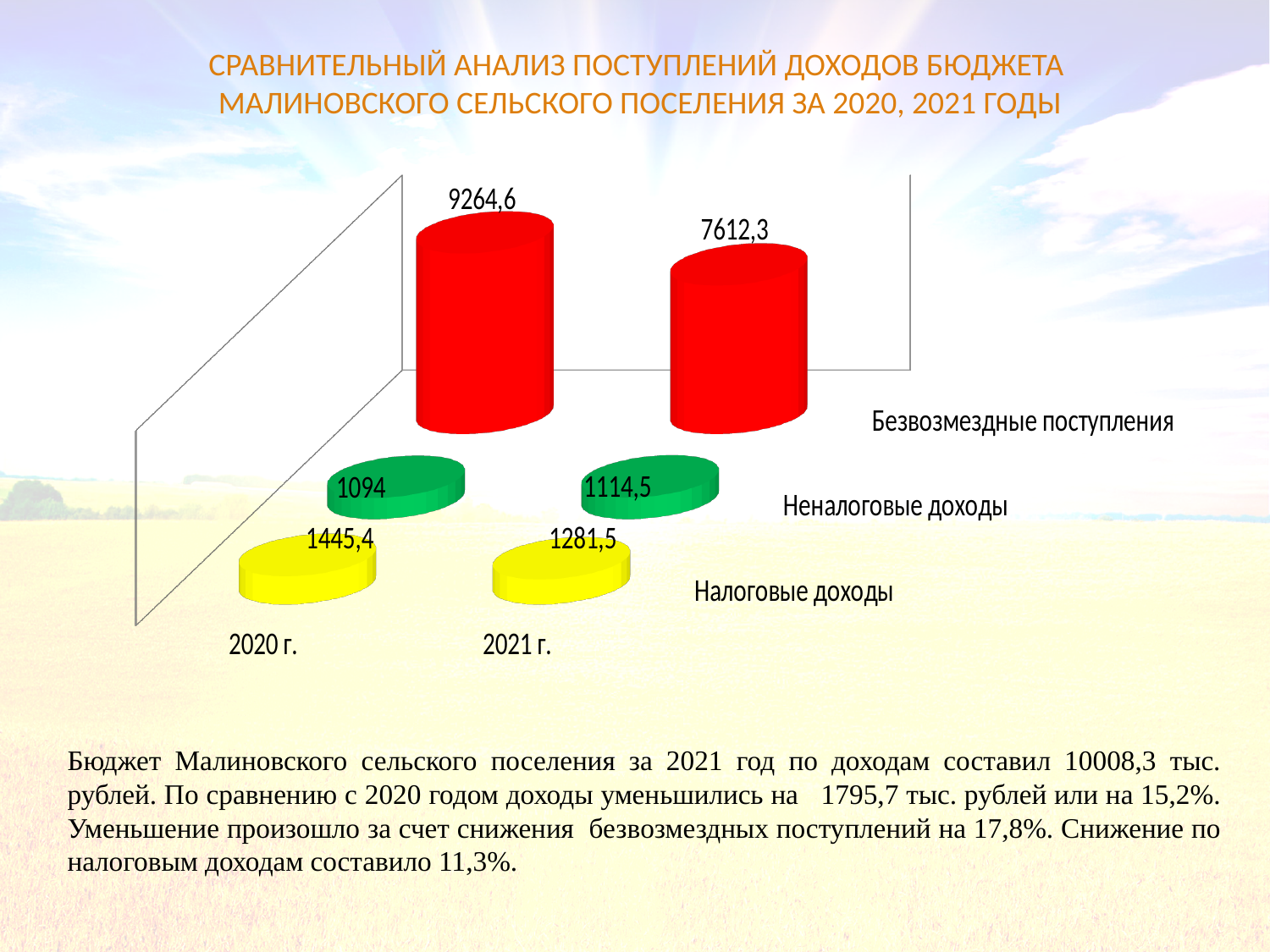
Which series has the lowest value for 2021 г.? Неналоговые доходы What is the value of Безвозмездные поступления for 2021 г.? 7612,3 What is the value of Неналоговые доходы for 2020 г.? 1094 What is the value of Налоговые доходы for 2021 г.? 1281,5 What type of chart is shown on the slide? Bar chart What is the difference between Безвозмездные поступления in 2020 г. and 2021 г.? 1652,3 Which series has the highest value for 2020 г.? Безвозмездные поступления How many series does the chart show? 3 Which is larger: Неналоговые доходы in 2020 г. or in 2021 г.? 2021 г. What is the difference between Налоговые доходы in 2020 г. and 2021 г.? 163,9 What is the value of Безвозмездные поступления for 2020 г.? 9264,6 How many year categories are shown on the x axis? 2